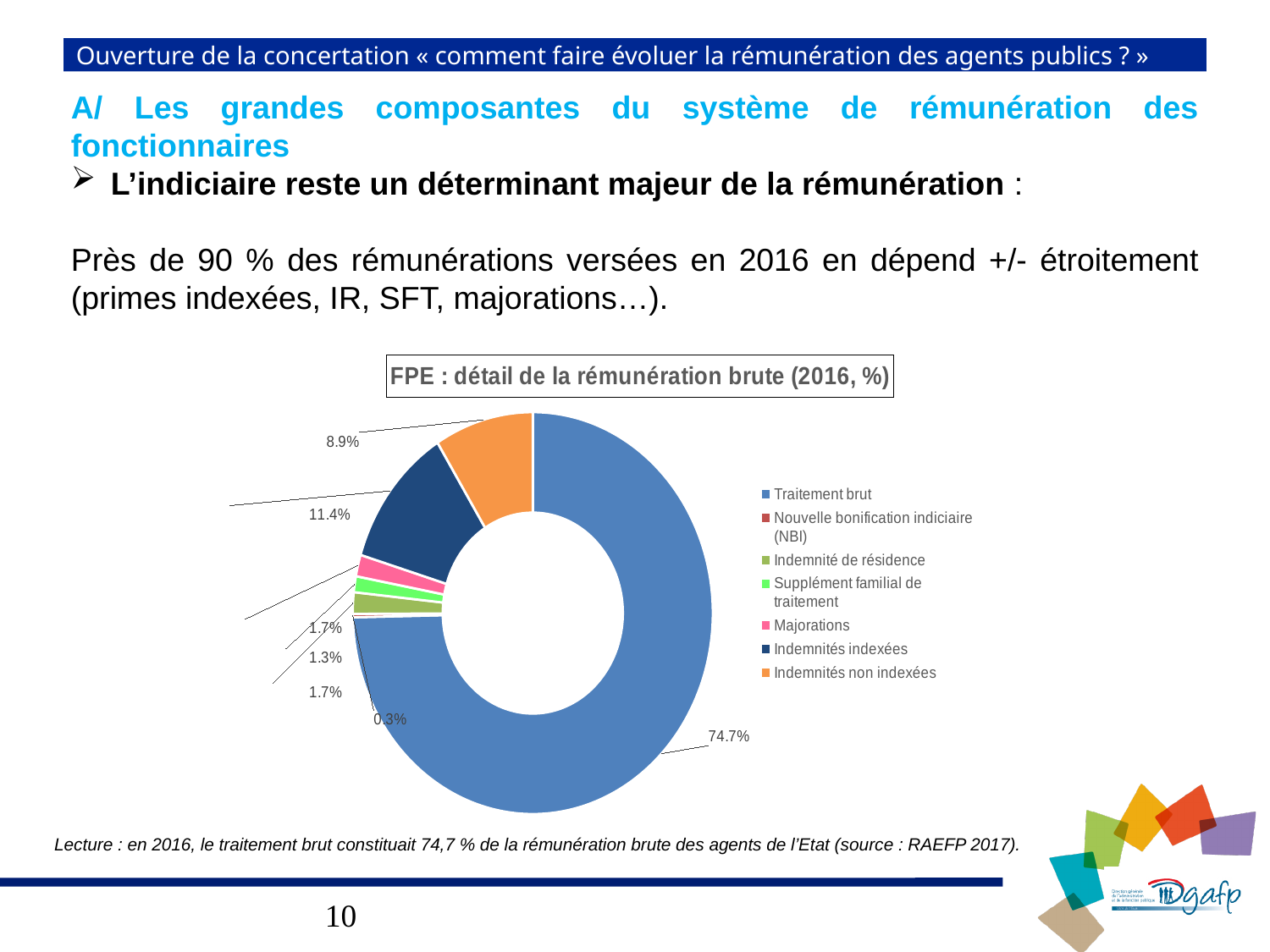
What kind of chart is shown on the slide? pie chart (doughnut) What is the title of the chart? FPE : détail de la rémunération brute (2016, %) What is the value shown for 'Supplément familial de traitement'? 1.3% What is the value shown for 'Indemnités non indexées'? 8.9% What is the value shown for 'Nouvelle bonification indiciaire (NBI)'? 0.3% Which is larger: the share of 'Indemnités indexées' or the share of 'Indemnités non indexées'? Indemnités indexées Which category has the smallest share of the pie? Nouvelle bonification indiciaire (NBI) What is the value shown for 'Indemnités indexées'? 11.4% What is the difference between the shares of 'Indemnités indexées' and 'Indemnités non indexées'? 2.5 percentage points What share of the gross remuneration does 'Traitement brut' represent? 74.7% Which category has the largest share of the pie? Traitement brut How many categories does the legend list? 7